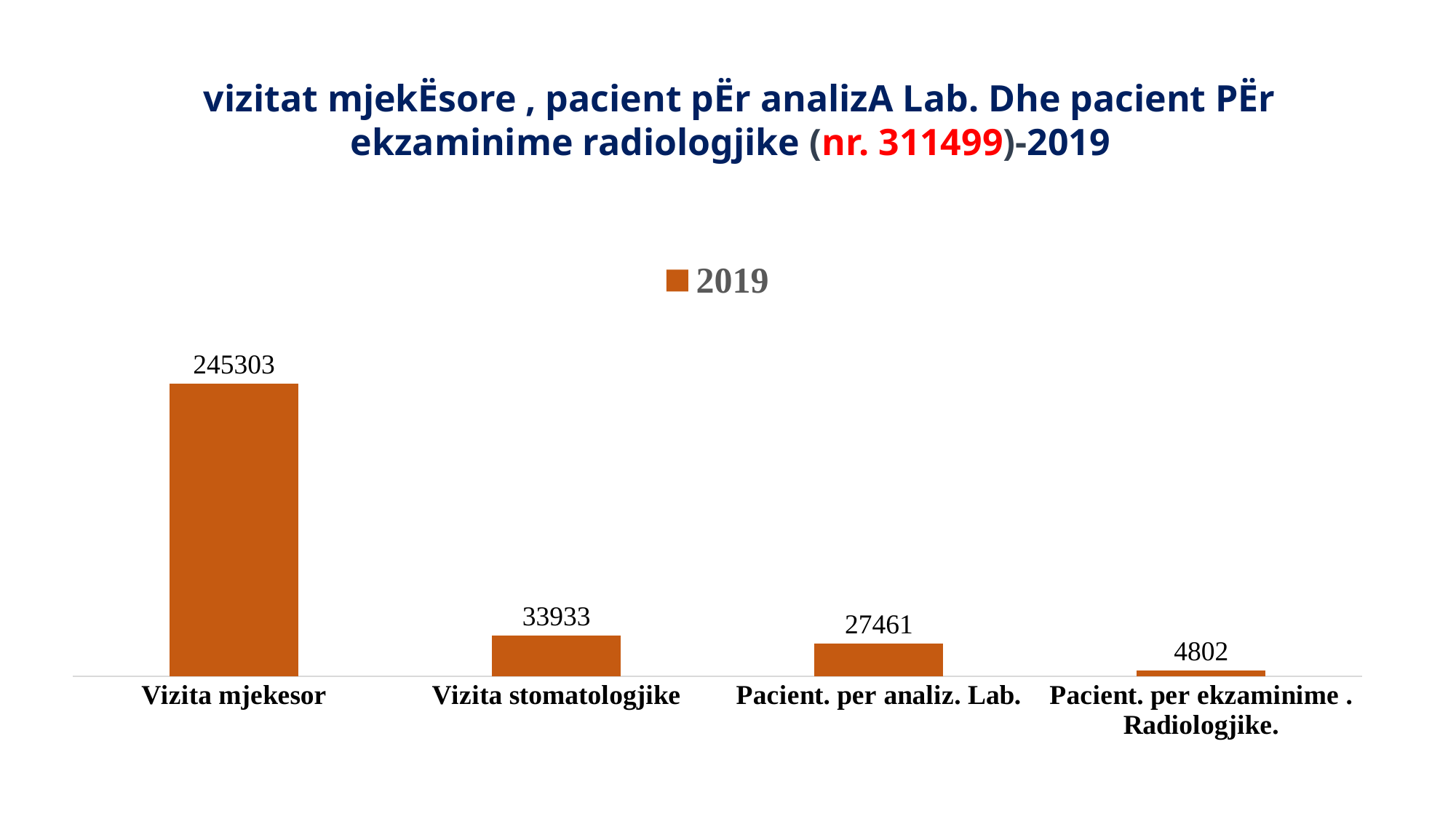
What is the value for Pacient. per ekzaminime . Radiologjike.? 4802 What is the value for Pacient. per analiz. Lab.? 27461 What is the value for Vizita stomatologjike? 33933 How many categories are shown on the chart? 4 What is the value for Vizita mjekesor? 245303 What is the difference between the values for Vizita stomatologjike and Pacient. per analiz. Lab.? 6472 How many series does the legend list? 1 What kind of chart is shown on the slide? Bar chart What is the difference between the values for Vizita mjekesor and Vizita stomatologjike? 211370 Which category has the highest value? Vizita mjekesor Which category has the lowest value? Pacient. per ekzaminime . Radiologjike. Which is larger, the value for Pacient. per analiz. Lab. or the value for Pacient. per ekzaminime . Radiologjike.? Pacient. per analiz. Lab.